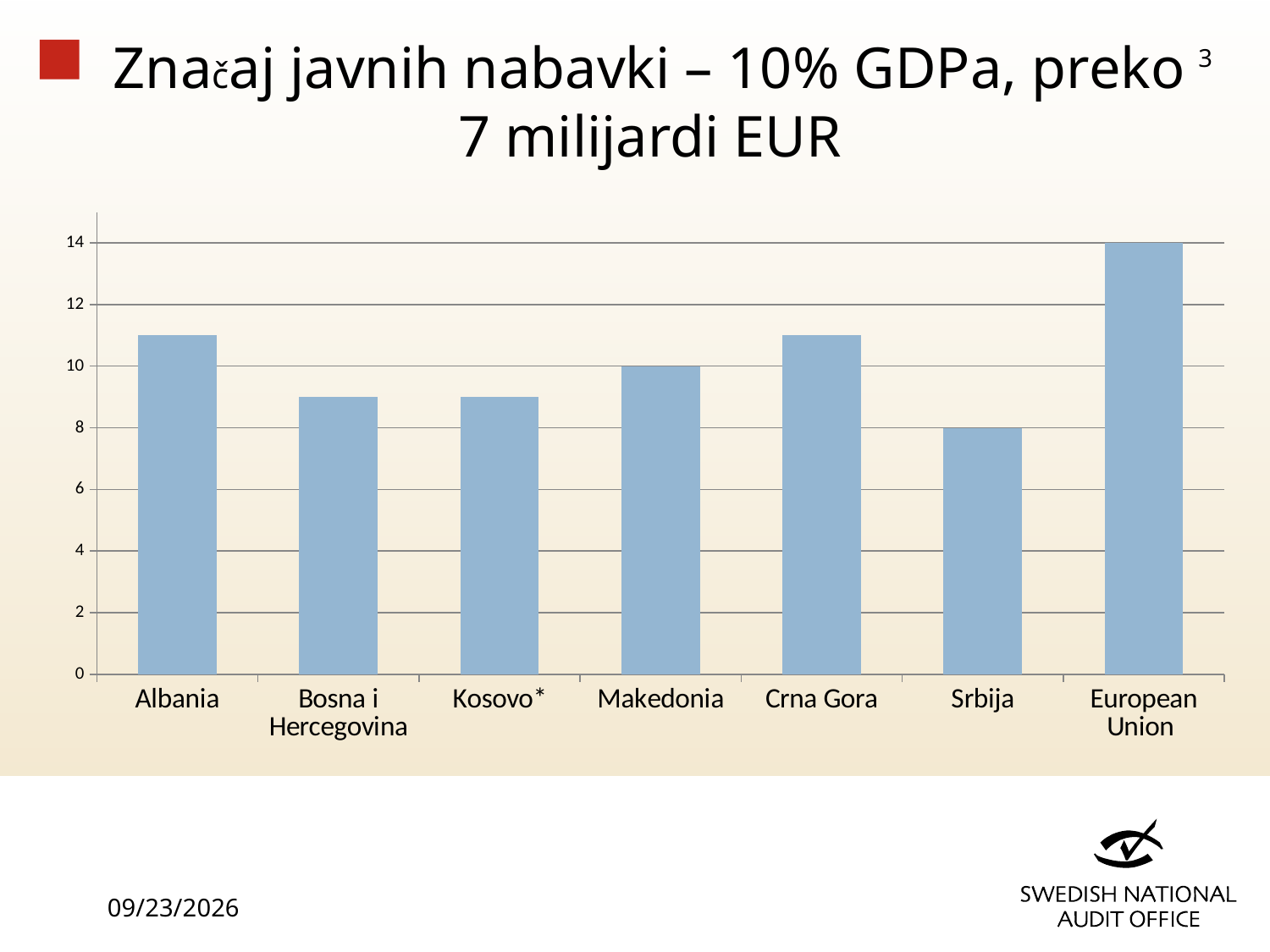
Which category has the highest bar in the chart? European Union What is the highest value shown on the y axis of the chart? 14 What type of chart is shown on the slide? bar chart Which is larger, the value for Crna Gora or the value for Kosovo*? Crna Gora What is the value for Srbija? 8 Is the value for Bosna i Hercegovina greater or less than 10? less How many categories are shown on the x axis of the chart? 7 What is the value for Makedonia? 10 What is the difference between the values for European Union and Srbija? 6 Which category has the lowest bar in the chart? Srbija Is the value for Albania greater or less than 10? greater What is the value for European Union? 14